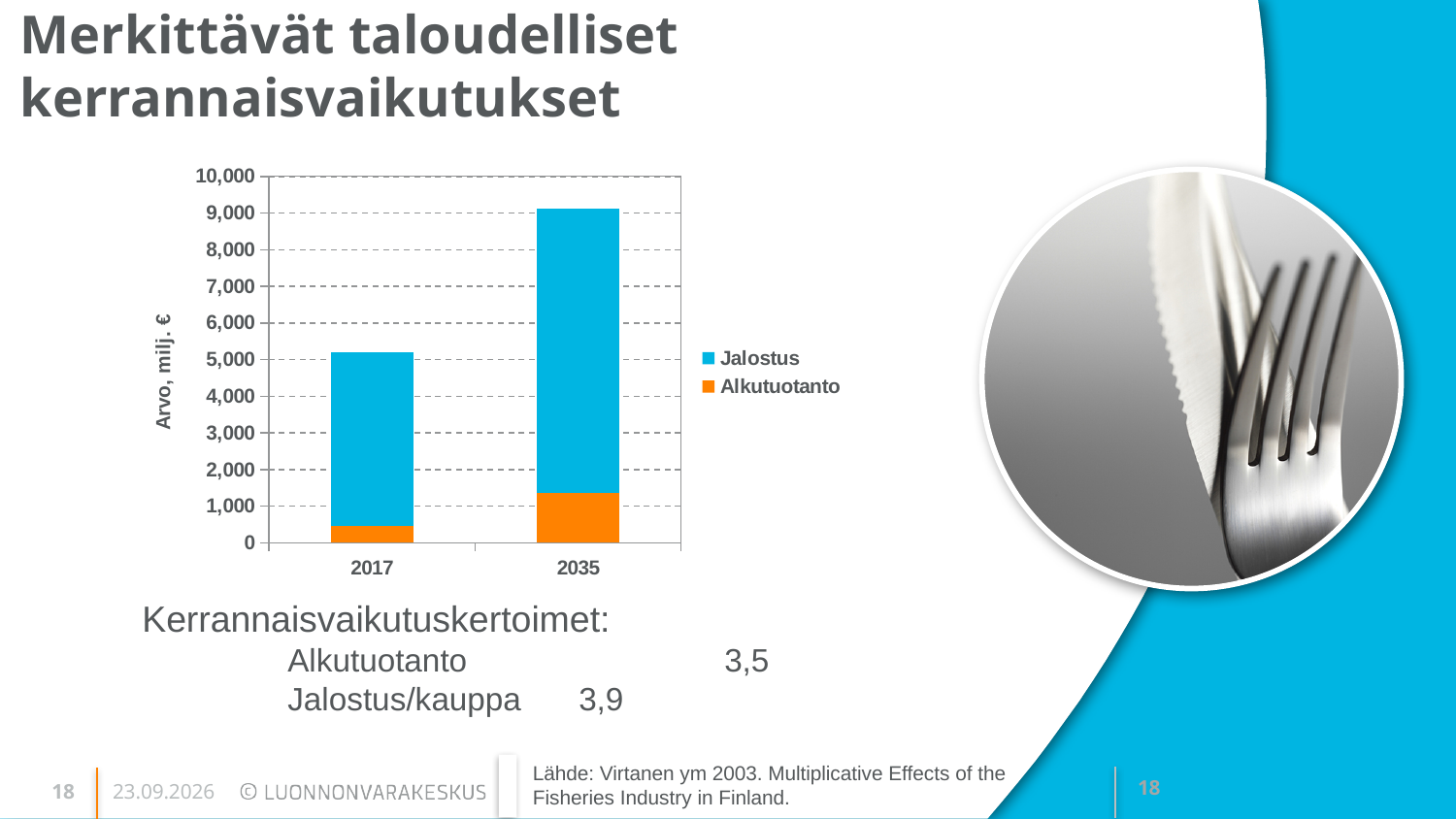
Do the total values rise or fall from 2017 to 2035? rise Which year has the taller stacked bar, 2017 or 2035? 2035 What kind of chart is shown on the slide? stacked bar chart Which year has the shorter stacked bar? 2017 Is the total value of the 2017 bar greater or less than 6,000? less Is the Jalostus segment larger in 2017 or in 2035? 2035 How many series does the chart's legend list? 2 How many categories are shown on the x axis of the chart? 2 What is the label on the chart's vertical axis? Arvo, milj. € Is the Alkutuotanto value for 2017 greater or less than 1,000? less Is the total value of the 2035 bar greater or less than 8,000? greater